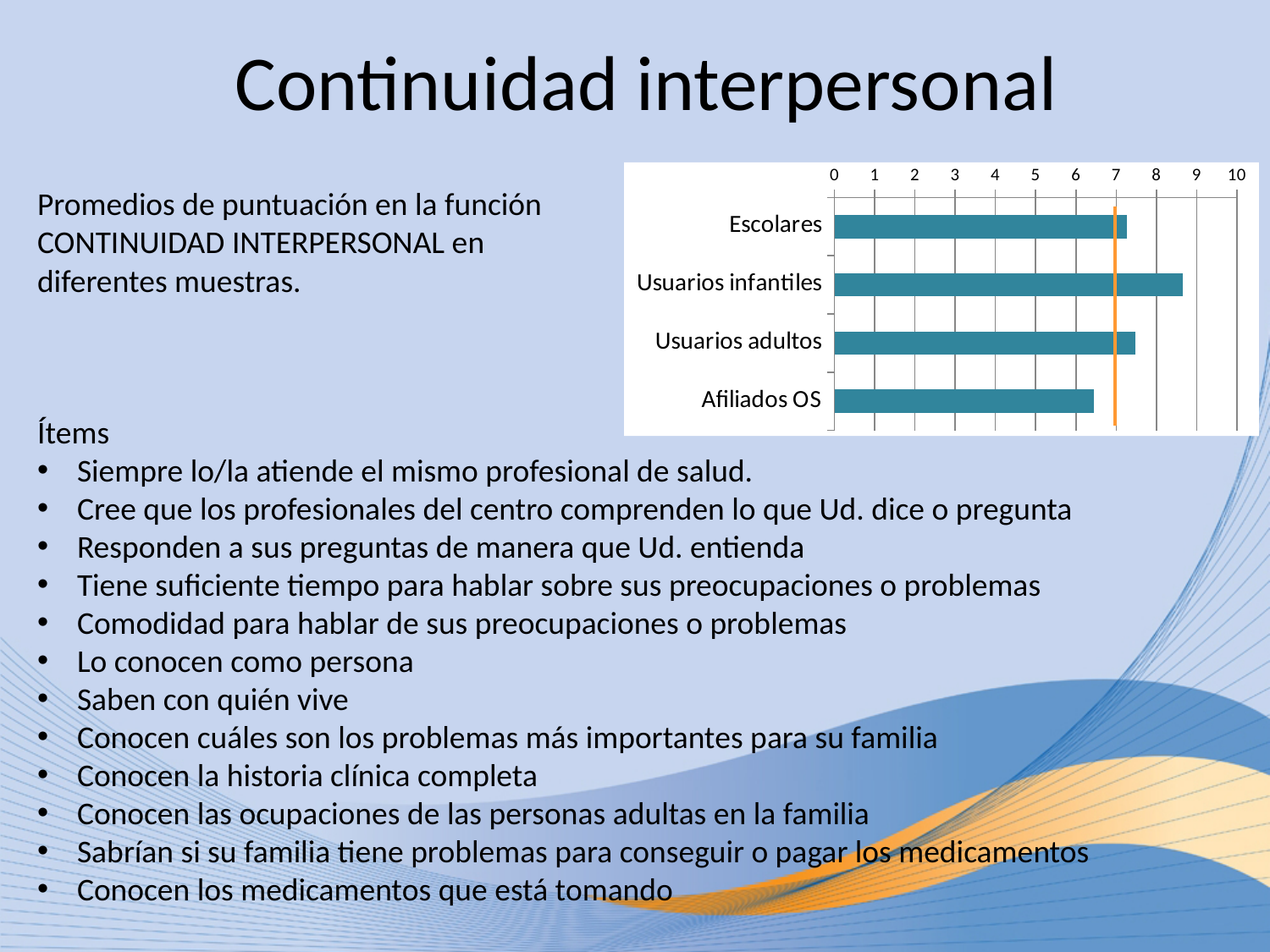
Is the value for Afiliados OS greater or less than 7? less What kind of chart is shown on the slide? bar chart Is the value for Usuarios adultos greater or less than 8? less Which category has the lowest value in the chart? Afiliados OS Is the value for Afiliados OS greater or less than 6? greater Which category has the highest value in the chart? Usuarios infantiles What is the maximum value shown on the chart's axis? 10 Which is larger, the value for Usuarios infantiles or the value for Afiliados OS? Usuarios infantiles How many categories are plotted in the chart? 4 Which is larger, the value for Usuarios adultos or the value for Afiliados OS? Usuarios adultos